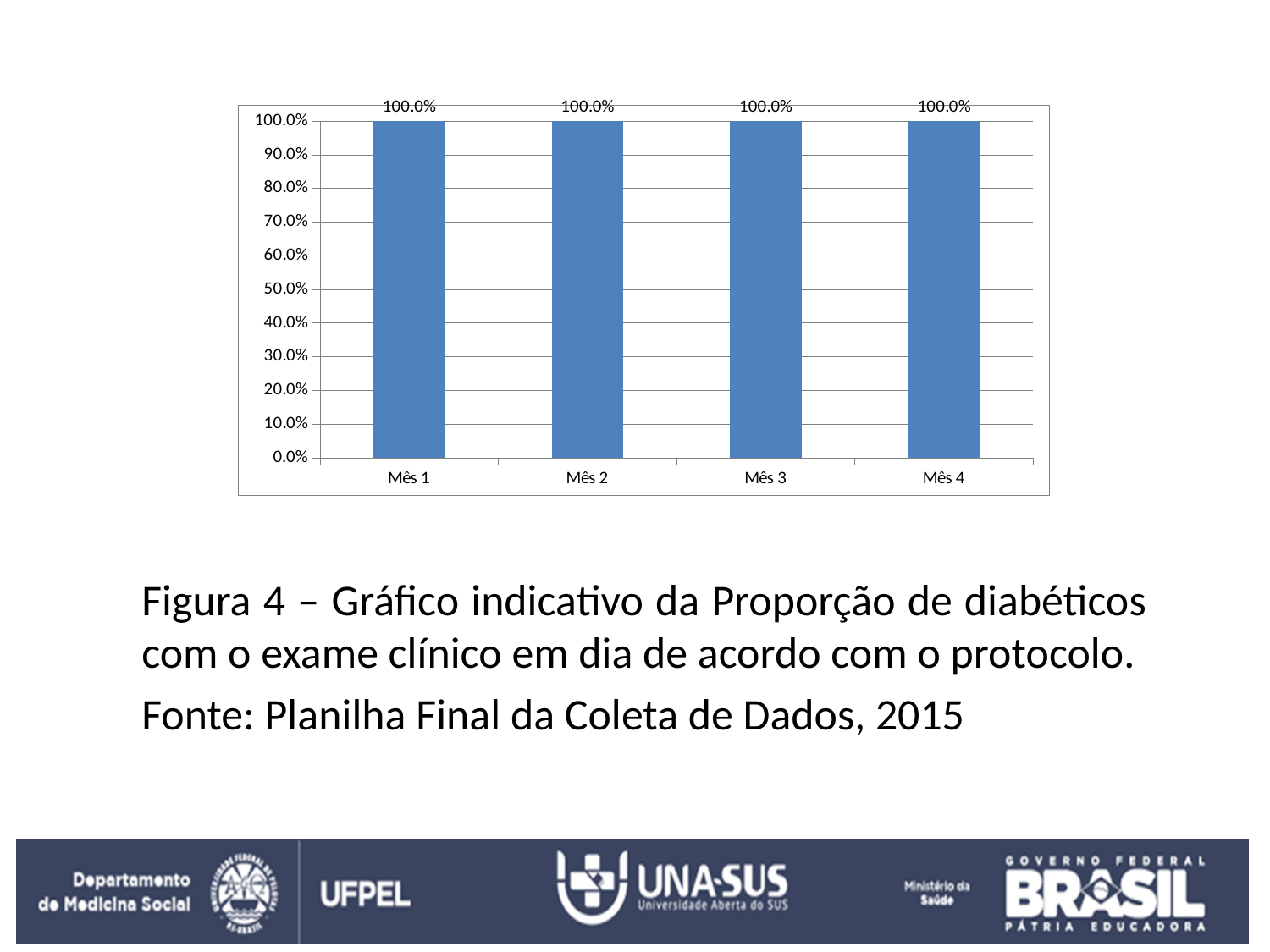
What is the value for Mês 3? 100.0% What kind of chart is shown on the slide? bar chart What is the value for Mês 1? 100.0% What is the difference between the values for Mês 1 and Mês 4? 0.0% According to the caption, what is the source of the data in the chart? Planilha Final da Coleta de Dados, 2015 Do the values rise, fall, or stay the same from Mês 1 to Mês 4? stay the same What is the value for Mês 4? 100.0% How many categories (months) are shown on the x axis? 4 Is the value for Mês 3 greater or less than 90.0%? greater What is the value for Mês 2? 100.0% What is the highest value shown on the y axis? 100.0%